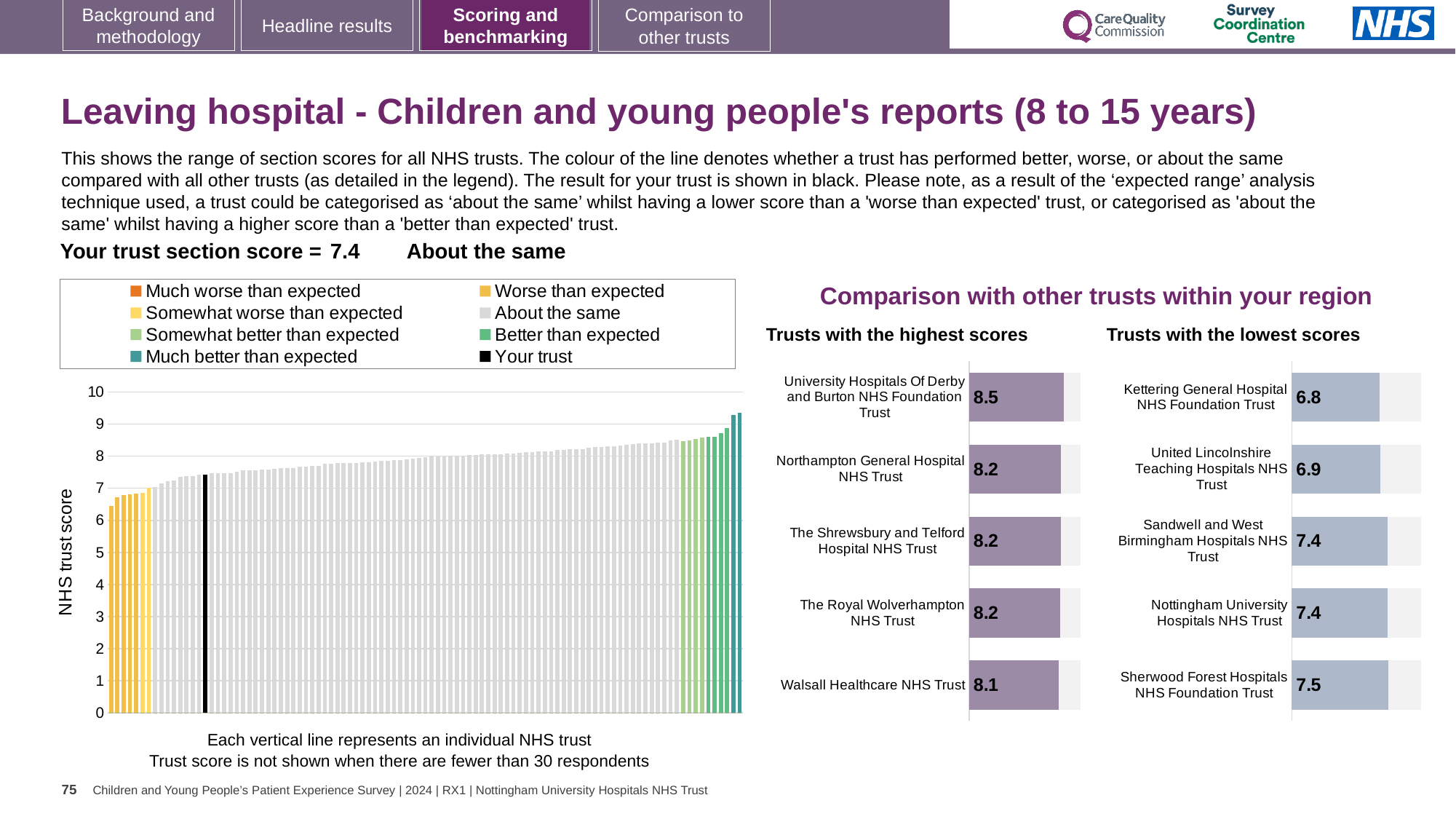
In the 'Trusts with the highest scores' chart, how many trusts are shown? 5 In the 'Trusts with the lowest scores' chart, what is the difference between the scores of Sherwood Forest Hospitals NHS Foundation Trust and Kettering General Hospital NHS Foundation Trust? 0.7 In the 'Trusts with the highest scores' chart, what is the score for University Hospitals Of Derby and Burton NHS Foundation Trust? 8.5 What kind of chart is the large chart on the left with the y axis labelled 'NHS trust score'? Bar chart How many entries does the legend of the large 'NHS trust score' chart on the left list? 8 In the large 'NHS trust score' chart on the left, do the values rise or fall from left to right? Rise In the 'Trusts with the lowest scores' chart, which has the larger score: United Lincolnshire Teaching Hospitals NHS Trust or Sandwell and West Birmingham Hospitals NHS Trust? Sandwell and West Birmingham Hospitals NHS Trust In the large 'NHS trust score' chart on the left, is the value of the black bar (your trust) greater or less than 8? less In the 'Trusts with the highest scores' chart, what is the difference between the scores of University Hospitals Of Derby and Burton NHS Foundation Trust and Walsall Healthcare NHS Trust? 0.4 In the 'Trusts with the highest scores' chart, which trust has the lowest score? Walsall Healthcare NHS Trust In the 'Trusts with the lowest scores' chart, what is the score for Kettering General Hospital NHS Foundation Trust? 6.8 In the 'Trusts with the lowest scores' chart, which trust has the highest score? Sherwood Forest Hospitals NHS Foundation Trust